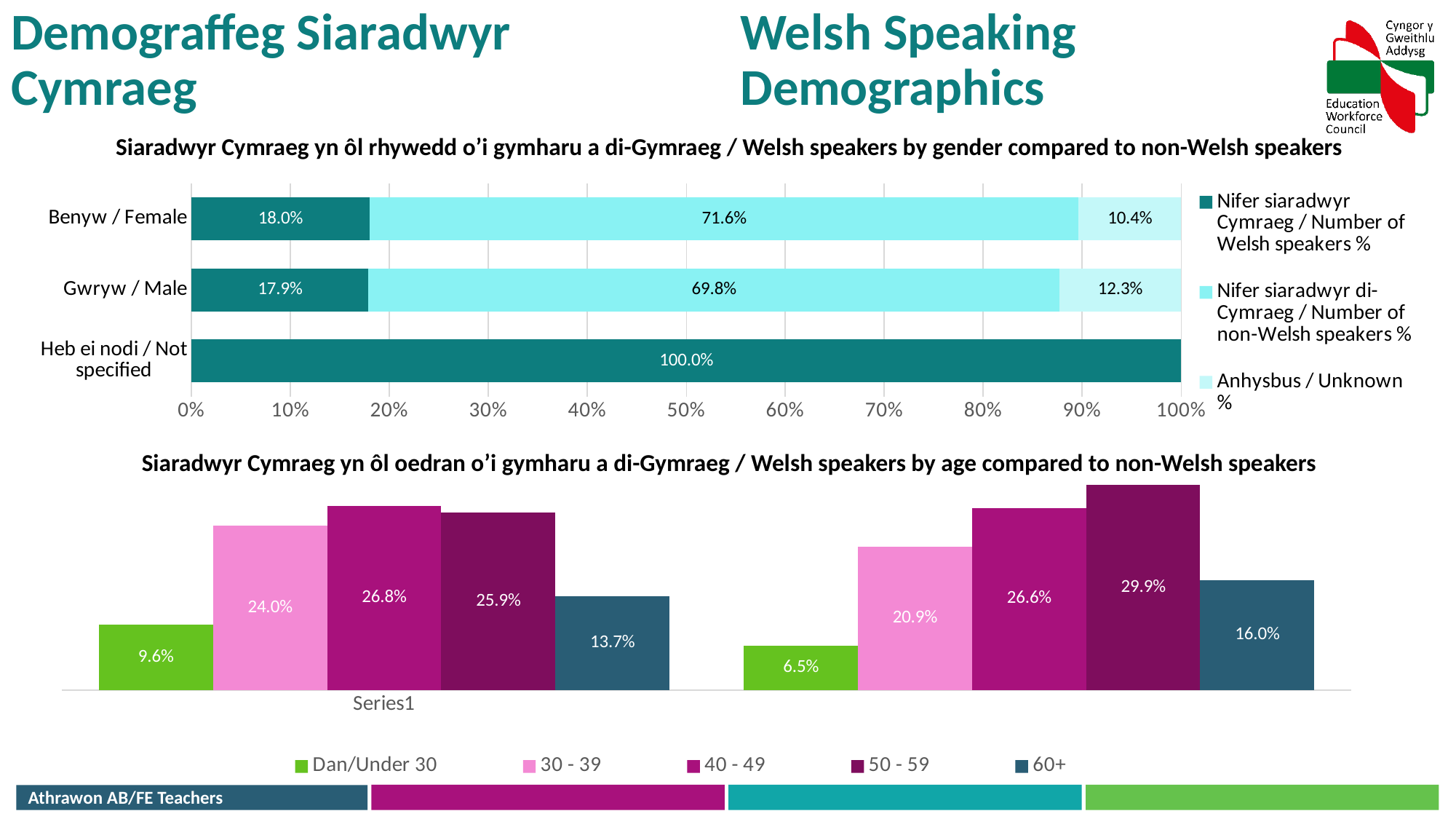
In the chart 'Welsh speakers by gender compared to non-Welsh speakers', how many categories are shown on the vertical axis? 3 In the chart 'Welsh speakers by age compared to non-Welsh speakers', how many age groups does the legend list? 5 In the chart 'Welsh speakers by gender compared to non-Welsh speakers', what is the value for Number of Welsh speakers % for Benyw / Female? 18.0% In the chart 'Welsh speakers by age compared to non-Welsh speakers', which age group has the lowest value in the left group (Series1)? Dan/Under 30 In the chart 'Welsh speakers by gender compared to non-Welsh speakers', what is the Unknown % value for Benyw / Female? 10.4% In the chart 'Welsh speakers by gender compared to non-Welsh speakers', how many series does the legend list? 3 In the chart 'Welsh speakers by gender compared to non-Welsh speakers', what is the value for Number of non-Welsh speakers % for Gwryw / Male? 69.8% In the chart 'Welsh speakers by age compared to non-Welsh speakers', which age group has the highest value in the right group of bars? 50 - 59 In the chart 'Welsh speakers by gender compared to non-Welsh speakers', what is the difference between the Unknown % values for Gwryw / Male and Benyw / Female? 1.9% In the chart 'Welsh speakers by age compared to non-Welsh speakers', what is the difference between the 60+ values in the right group and the left group (Series1)? 2.3% What kind of chart is 'Welsh speakers by gender compared to non-Welsh speakers'? Stacked bar chart In the chart 'Welsh speakers by age compared to non-Welsh speakers', what is the value for 40 - 49 in the left group (Series1)? 26.8%